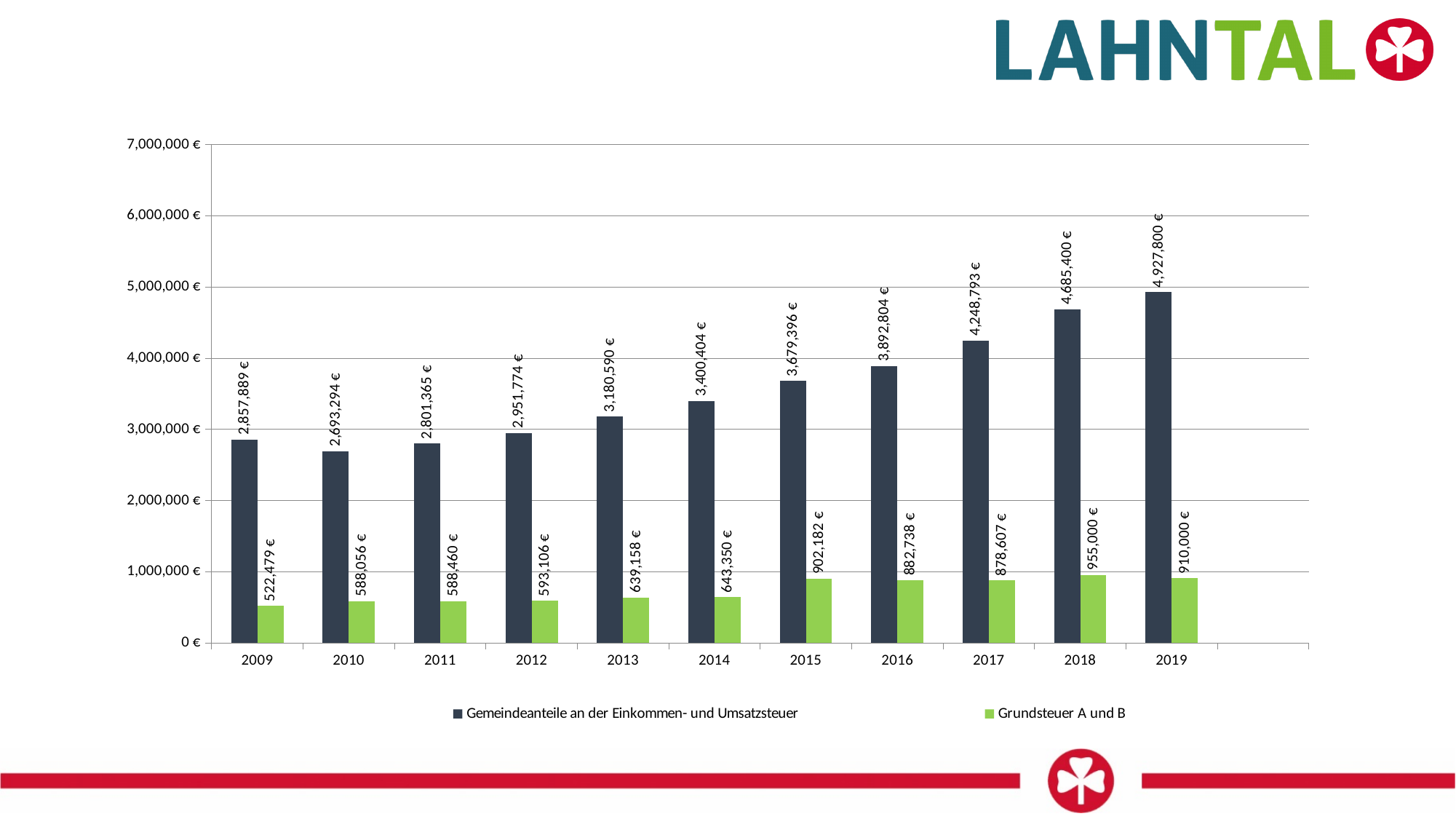
In which year is Gemeindeanteile an der Einkommen- und Umsatzsteuer lowest? 2010 What is the value for Gemeindeanteile an der Einkommen- und Umsatzsteuer in 2019? 4,927,800 € What is the difference between Grundsteuer A und B in 2018 and in 2019? 45,000 € In which year is Grundsteuer A und B lowest? 2009 How many years are shown on the x axis? 11 Which is larger: Grundsteuer A und B in 2016 or in 2017? 2016 What is the value for Gemeindeanteile an der Einkommen- und Umsatzsteuer in 2013? 3,180,590 € What is the value for Grundsteuer A und B in 2015? 902,182 € By how much did Gemeindeanteile an der Einkommen- und Umsatzsteuer increase from 2018 to 2019? 242,400 € In which year is Grundsteuer A und B highest? 2018 How many series does the legend list? 2 What kind of chart is shown on the slide? Bar chart